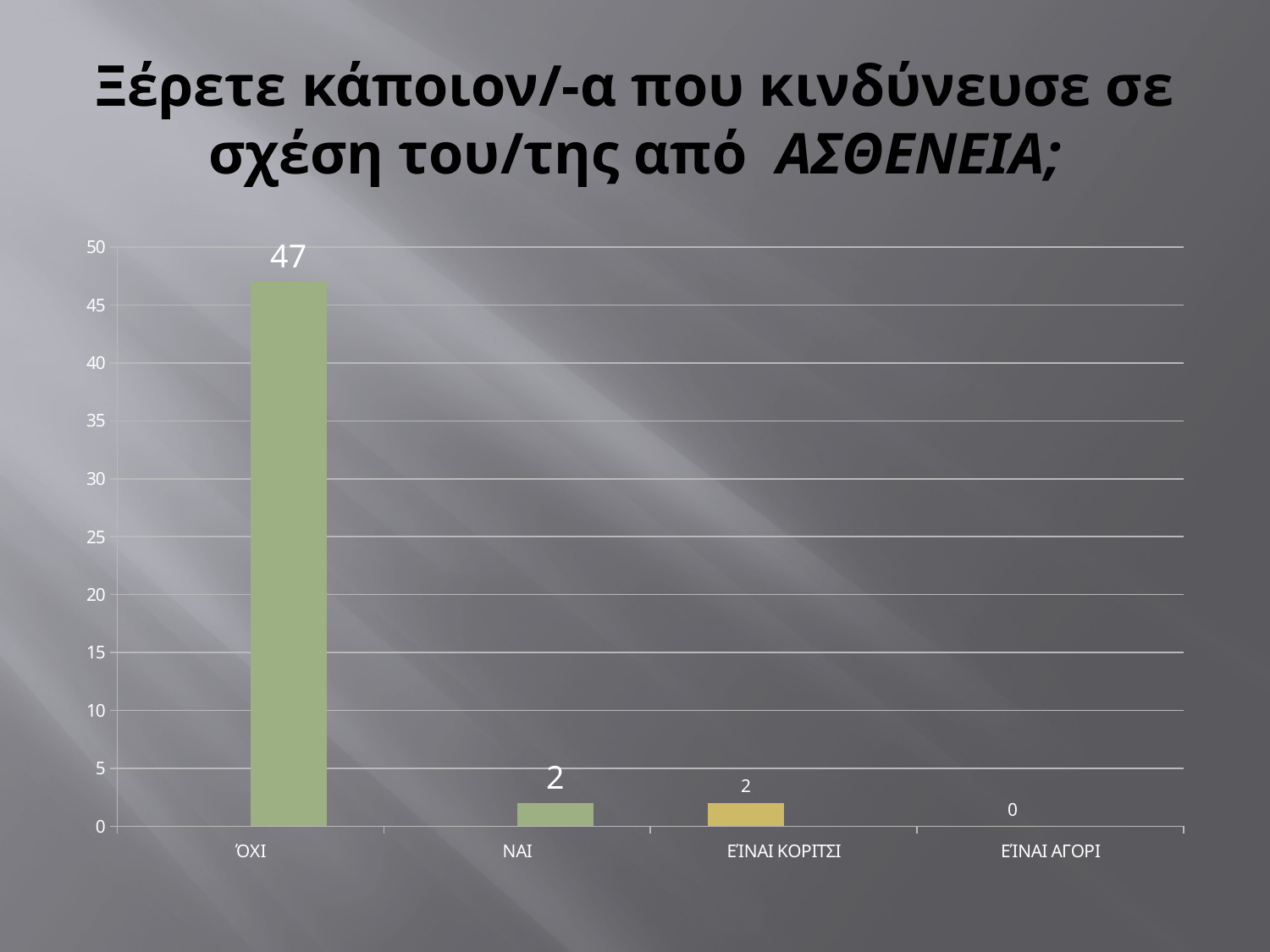
Which category has the lowest value? ΕΊΝΑΙ ΑΓΟΡΙ What is the value for ΝΑΙ? 2 Is the value for ΌΧΙ greater or less than 45? greater What is the value for ΕΊΝΑΙ ΑΓΟΡΙ? 0 Which is larger, the value for ΌΧΙ or the value for ΕΊΝΑΙ ΚΟΡΙΤΣΙ? ΌΧΙ What kind of chart is shown on the slide? bar chart What is the value for ΌΧΙ? 47 What is the maximum value shown on the y axis? 50 What is the value for ΕΊΝΑΙ ΚΟΡΙΤΣΙ? 2 Which category has the highest value? ΌΧΙ How many categories are shown on the x axis? 4 What is the difference between the values for ΌΧΙ and ΝΑΙ? 45